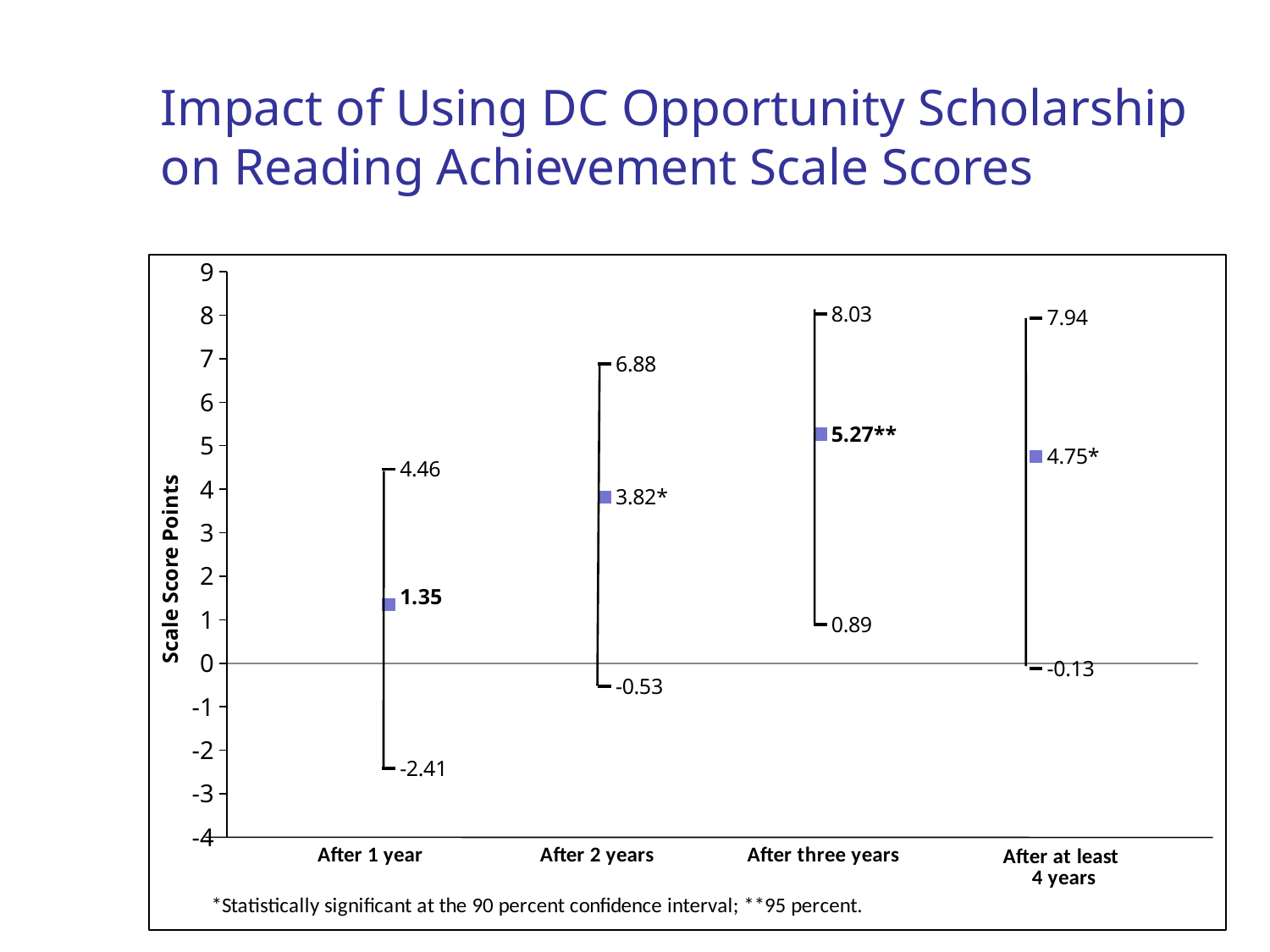
What is the upper confidence bound for After 2 years? 6.88 Which category's point estimate is marked as statistically significant at the 95 percent confidence interval? After three years What is the lower confidence bound for After at least 4 years? -0.13 What is the difference between the point estimates for After three years and After 1 year? 3.92 What is the point estimate for After 1 year? 1.35 What is the point estimate for After three years? 5.27** How many categories are shown on the x axis? 4 Which category has the lowest point estimate? After 1 year Which is larger, the point estimate for After 2 years or After at least 4 years? After at least 4 years What is the label of the y axis? Scale Score Points Do the point estimates rise or fall from After 1 year to After three years? rise Which category has the highest point estimate? After three years